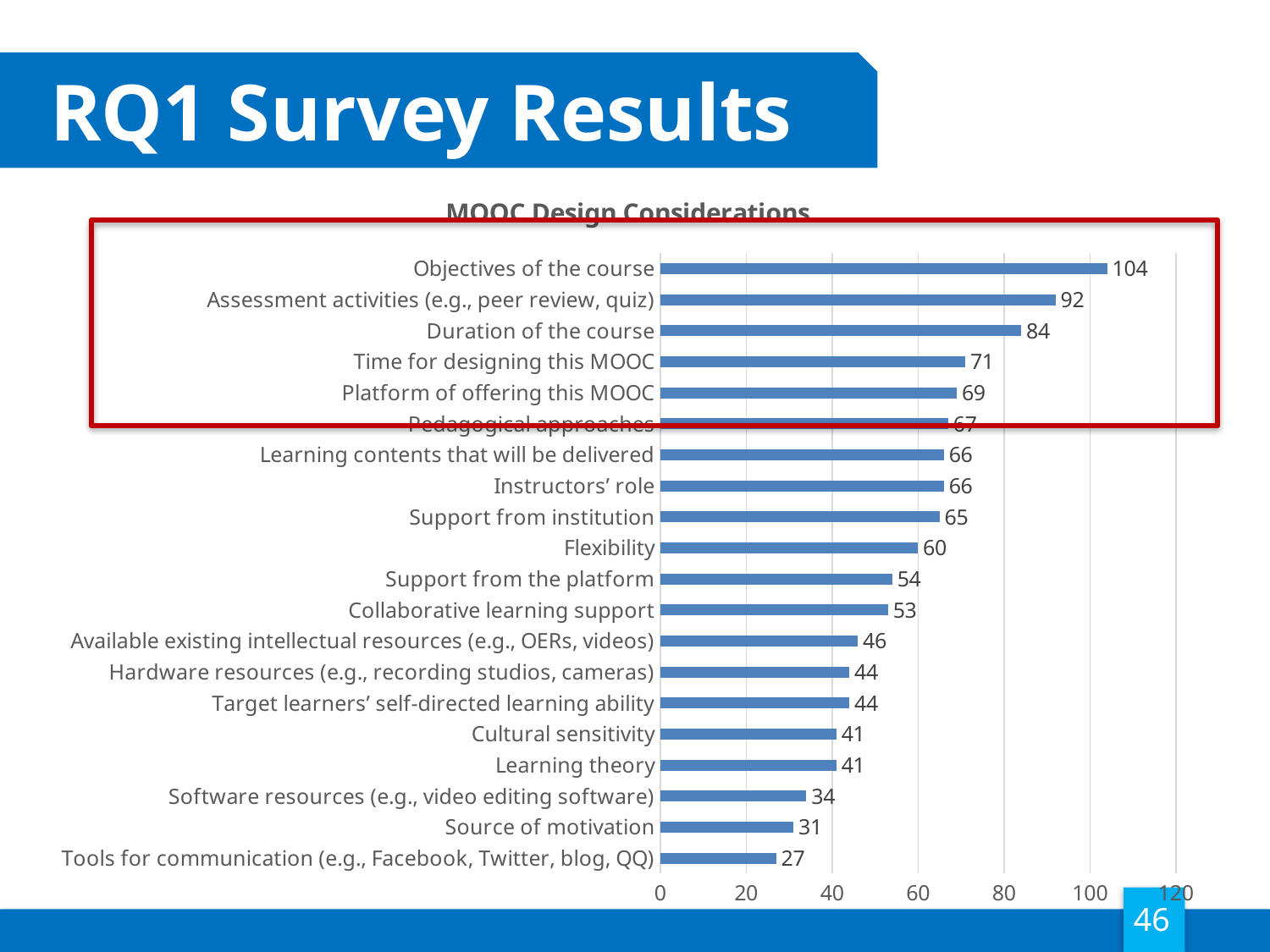
What kind of chart is shown on the slide? bar chart Is the value for Time for designing this MOOC greater or less than 60? greater Which category has the highest value? Objectives of the course What is the title of the chart? MOOC Design Considerations How many categories are plotted in the chart? 20 What is the value for Duration of the course? 84 What is the value for Objectives of the course? 104 Which category has the lowest value? Tools for communication (e.g., Facebook, Twitter, blog, QQ) What is the value for Flexibility? 60 What is the difference between the values for Objectives of the course and Assessment activities (e.g., peer review, quiz)? 12 What is the value for Source of motivation? 31 Which has a larger value, Support from the platform or Cultural sensitivity? Support from the platform